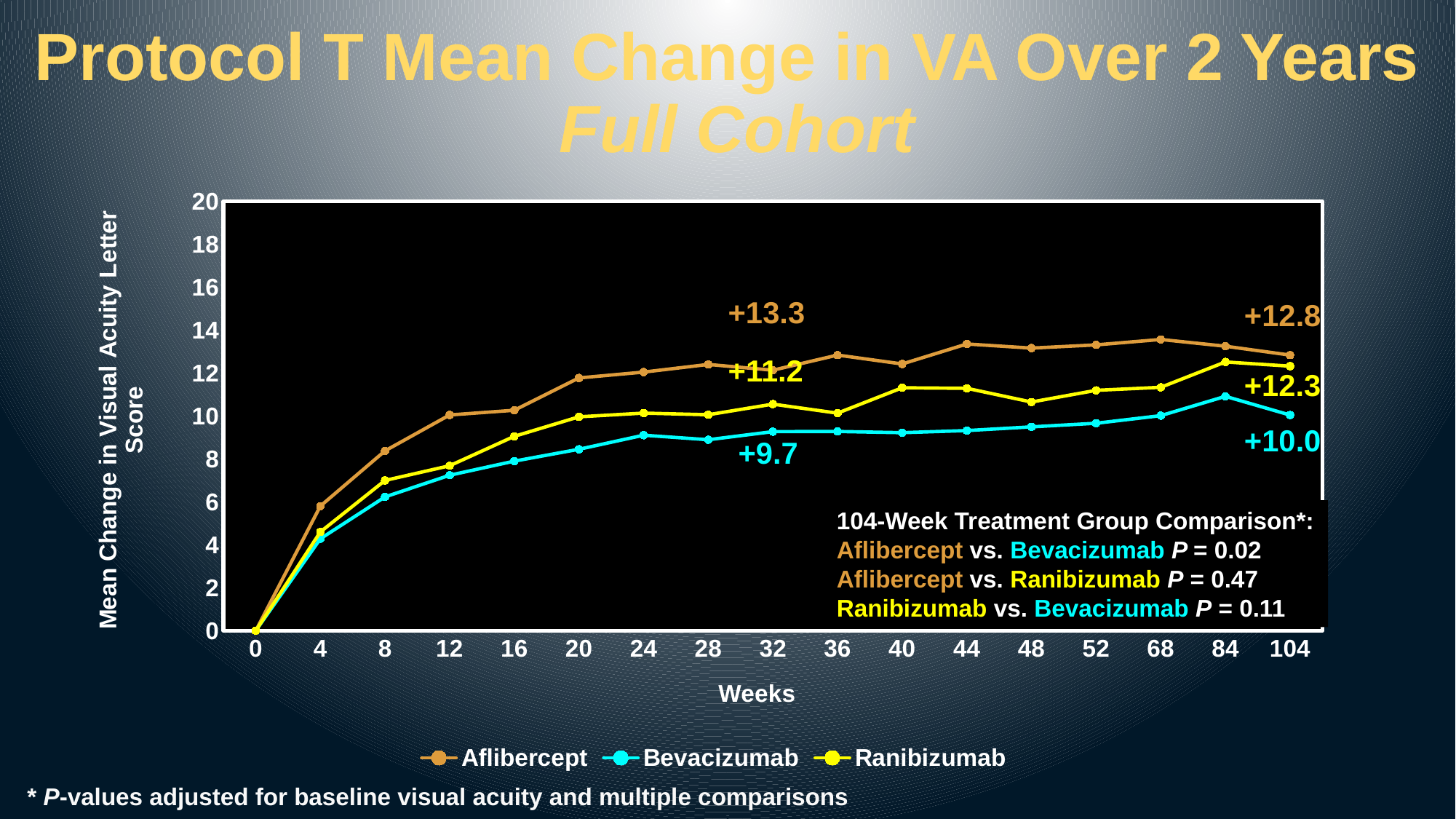
Which treatment group has the lowest mean change in VA at week 104? Bevacizumab What is the mean change in visual acuity letter score for Aflibercept at week 104? +12.8 What is the difference between the Aflibercept and Bevacizumab values at week 104? 2.8 What is the label on the x axis? Weeks Do the values for each treatment group generally rise or fall from week 0 to week 104? rise How many series does the legend list? 3 What kind of chart is shown on the slide? line chart What is the mean change in visual acuity letter score for Ranibizumab at week 104? +12.3 How many time points are shown on the x axis? 17 What is the mean change in visual acuity letter score for Bevacizumab at week 104? +10.0 Is the value for Bevacizumab at week 4 greater or less than 6? less Which treatment group has the highest mean change in VA at week 104? Aflibercept